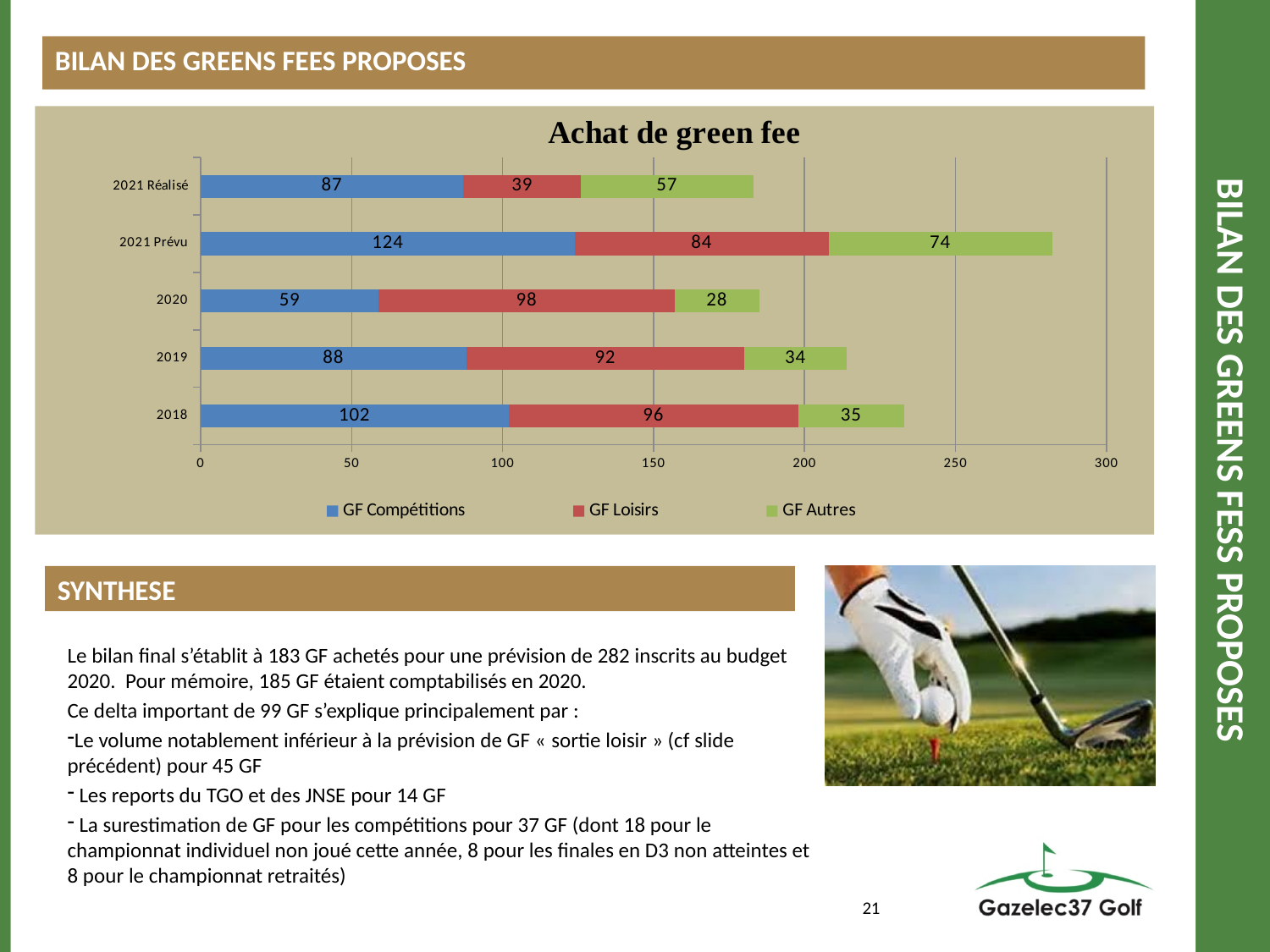
How many series does the chart legend list? 3 How many categories are plotted on the chart? 5 What is the title of the chart? Achat de green fee What is the GF Autres value for 2020? 28 What is the GF Loisirs value for 2021 Réalisé? 39 Which category has the highest GF Autres value? 2021 Prévu Which category has the lowest GF Compétitions value? 2020 Which is larger, the GF Compétitions value for 2018 or for 2019? 2018 What is the total of the stacked bar for 2021 Réalisé? 183 What is the difference between the GF Loisirs values for 2021 Prévu and 2021 Réalisé? 45 What is the GF Compétitions value for 2021 Prévu? 124 What type of chart is shown on the slide? Stacked bar chart